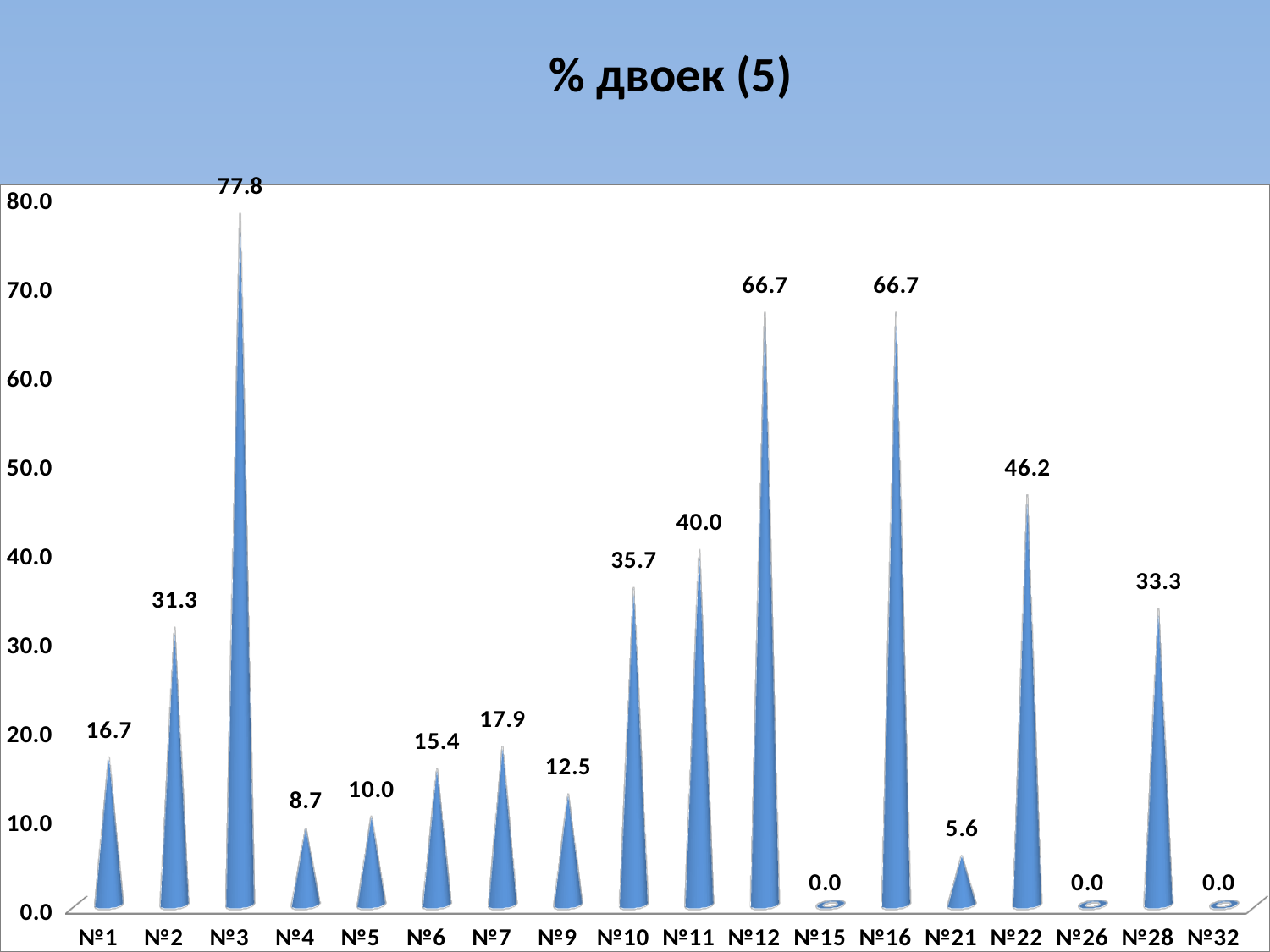
What is the value for №22? 46.2 Which is larger, the value for №2 or the value for №28? №28 What is the difference between the values for №11 and №10? 4.3 What is the difference between the values for №3 and №12? 11.1 Is the value for №22 greater or less than 40.0? greater Which category has the highest value? №3 What type of chart is shown on the slide? bar chart How many categories are shown on the x axis? 18 What is the title of the chart? % двоек (5) What is the lowest value shown on the chart? 0.0 What is the value for №3? 77.8 What is the value for №21? 5.6